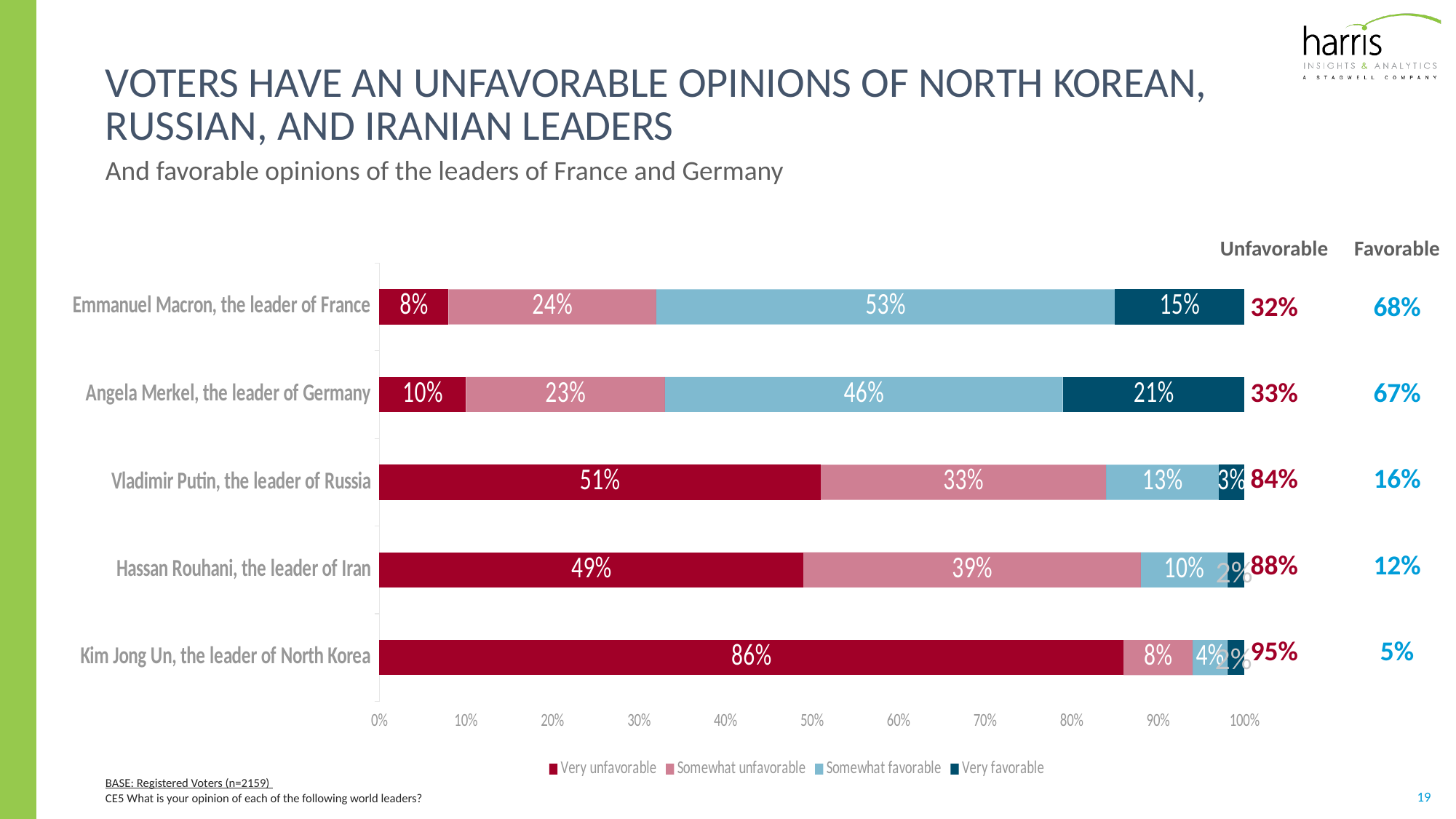
What percentage of voters have a very unfavorable opinion of Kim Jong Un, the leader of North Korea? 86% What is the difference between the somewhat unfavorable percentages for Hassan Rouhani and Vladimir Putin? 6% How many series does the legend list? 4 What is the very favorable percentage for Angela Merkel, the leader of Germany? 21% How many leaders are shown in the chart? 5 What is the total of the stacked bar for Emmanuel Macron, the leader of France? 100% Who has a larger somewhat favorable percentage, Vladimir Putin or Hassan Rouhani? Vladimir Putin What percentage of voters have a somewhat favorable opinion of Emmanuel Macron, the leader of France? 53% Which leader has the highest very unfavorable percentage? Kim Jong Un, the leader of North Korea Which leader has the lowest very unfavorable percentage? Emmanuel Macron, the leader of France What is the overall Favorable percentage shown for Vladimir Putin, the leader of Russia? 16% What kind of chart is shown on the slide? Stacked bar chart